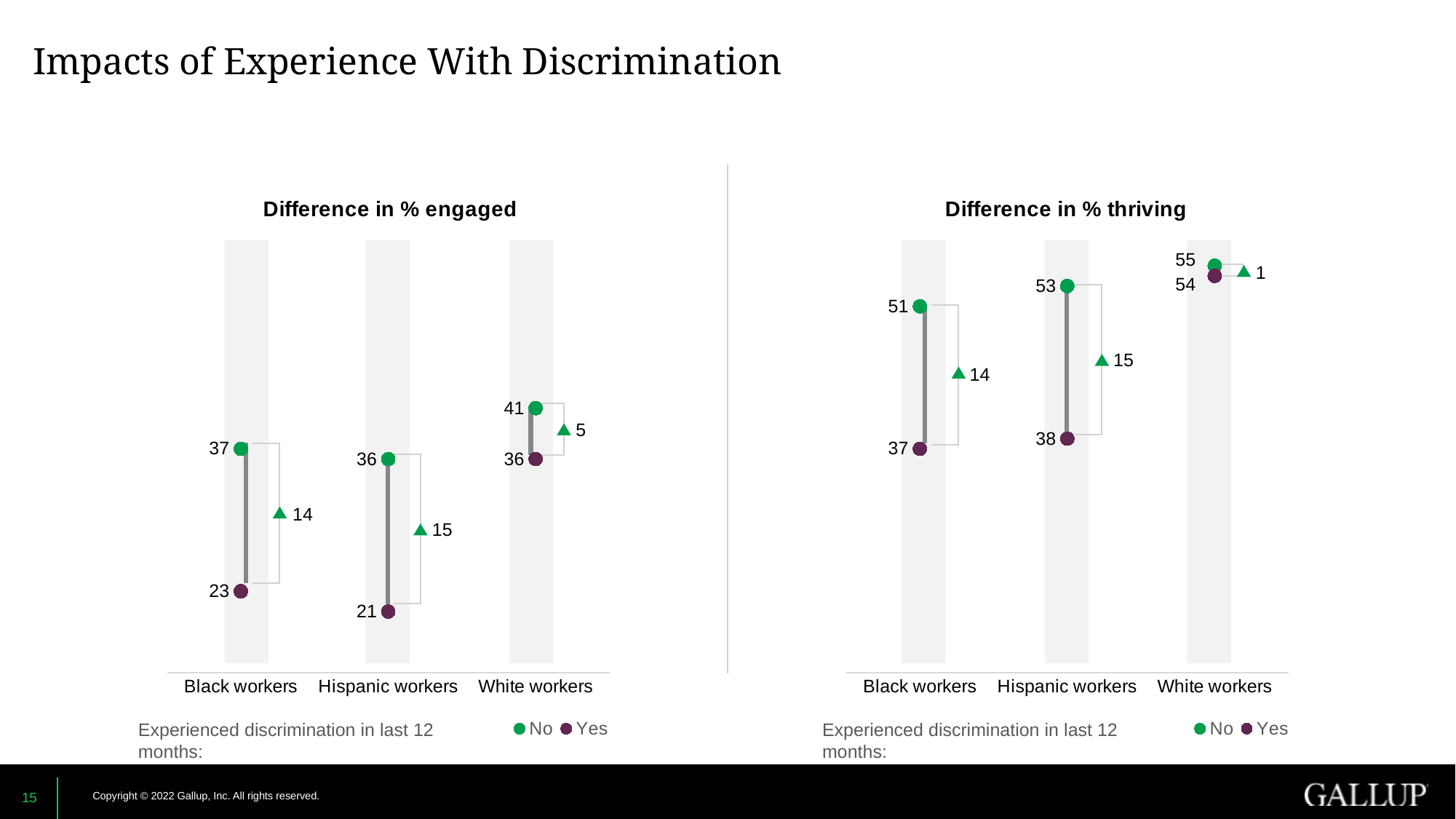
What is the title of the chart on the right side of the slide? Difference in % thriving How many series does the legend of the 'Difference in % engaged' chart list? 2 In the 'Difference in % thriving' chart, which group has the lowest 'Yes' value? Black workers In the 'Difference in % thriving' chart, which is larger: the 'No' value for Black workers or the 'No' value for Hispanic workers? Hispanic workers In the 'Difference in % engaged' chart, which group has the highest 'No' value? White workers In the 'Difference in % thriving' chart, what is the value for Hispanic workers who did not experience discrimination (No)? 53 In the 'Difference in % engaged' chart, what is the difference between the 'No' and 'Yes' values for Black workers? 14 In the 'Difference in % engaged' chart, what is the difference shown for White workers? 5 How many groups are shown on the x axis of the 'Difference in % thriving' chart? 3 In the 'Difference in % engaged' chart, what is the value for Hispanic workers who experienced discrimination (Yes)? 21 In the 'Difference in % thriving' chart, what is the value for White workers who experienced discrimination (Yes)? 54 In the 'Difference in % engaged' chart, what is the value for Black workers who did not experience discrimination (No)? 37